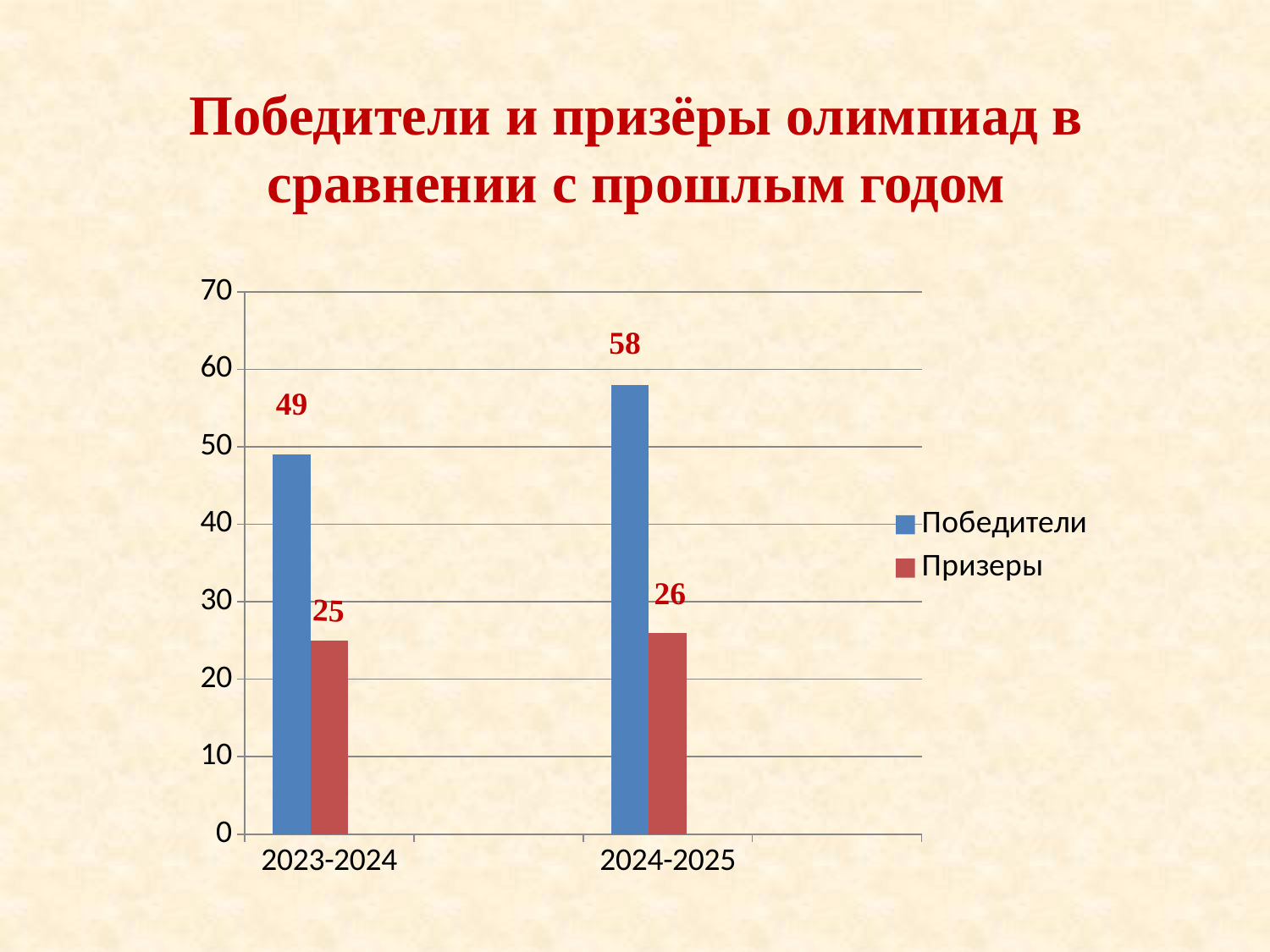
What is the value for Победители in 2023-2024? 49 What is the value for Победители in 2024-2025? 58 How many categories are shown on the x axis? 2 What is the value for Призеры in 2023-2024? 25 Which year has the higher value for Победители? 2024-2025 Does the value for Призеры rise or fall from 2023-2024 to 2024-2025? Rise Which is larger in 2024-2025: Победители or Призеры? Победители What is the difference between Победители in 2024-2025 and Победители in 2023-2024? 9 How many series does the legend list? 2 What is the difference between Победители and Призеры in 2023-2024? 24 What kind of chart is shown on the slide? Bar chart What is the value for Призеры in 2024-2025? 26